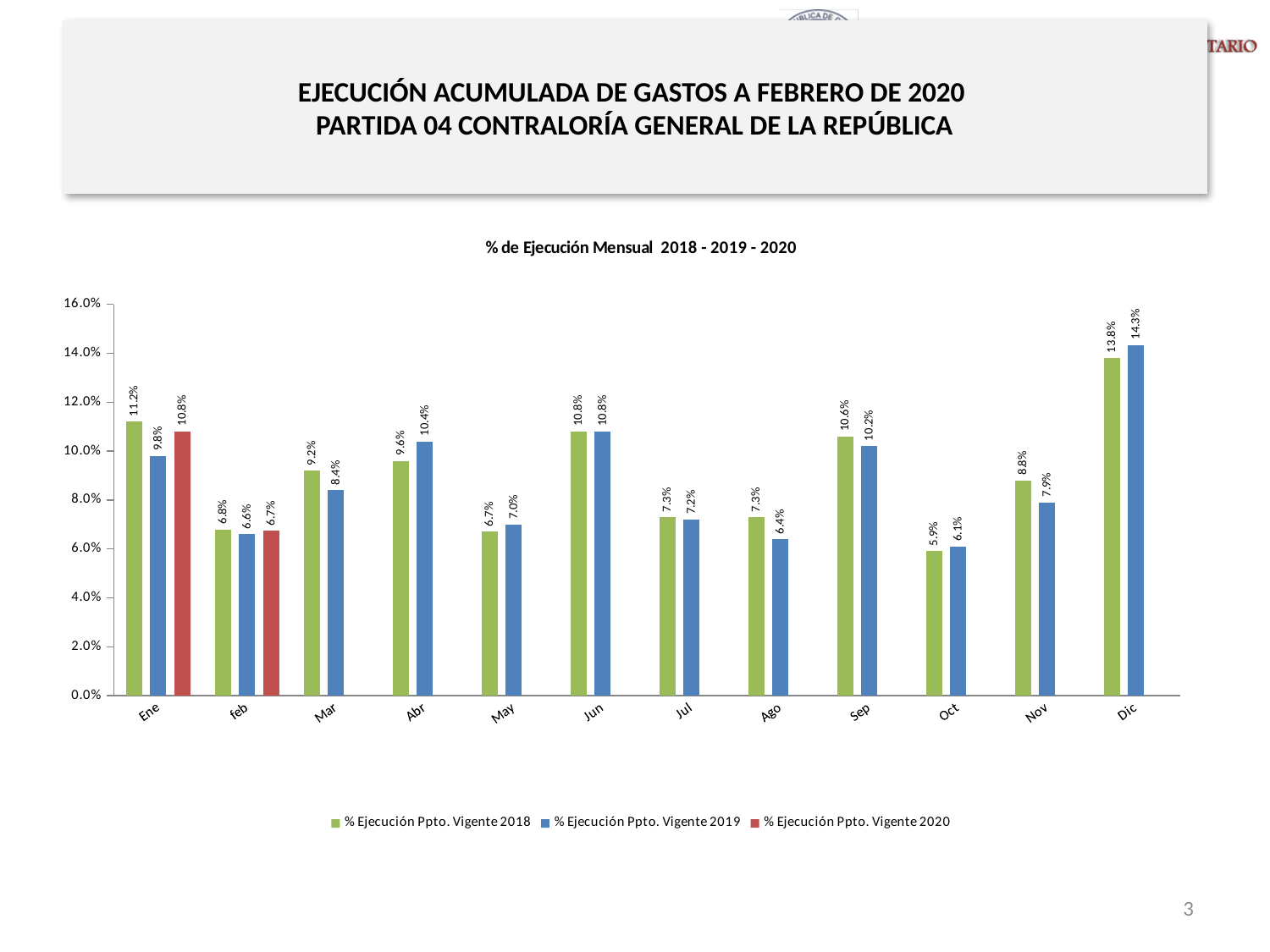
What is the value for Dic in the % Ejecución Ppto. Vigente 2019 series? 14.3% How many months are shown on the x axis? 12 Which month has the lowest value in the % Ejecución Ppto. Vigente 2019 series? Oct What is the value for Sep in the % Ejecución Ppto. Vigente 2018 series? 10.6% What colour represents the % Ejecución Ppto. Vigente 2020 series? Red What kind of chart is shown on the slide? Bar chart How many series does the legend list? 3 What is the value for Ene in the % Ejecución Ppto. Vigente 2020 series? 10.8% For Nov, which series has the larger value, 2018 or 2019? 2018 Which month has the highest value in the % Ejecución Ppto. Vigente 2018 series? Dic What is the difference between the 2019 and 2018 values for Dic? 0.5% What is the difference between the 2018 and 2019 values for Ene? 1.4%